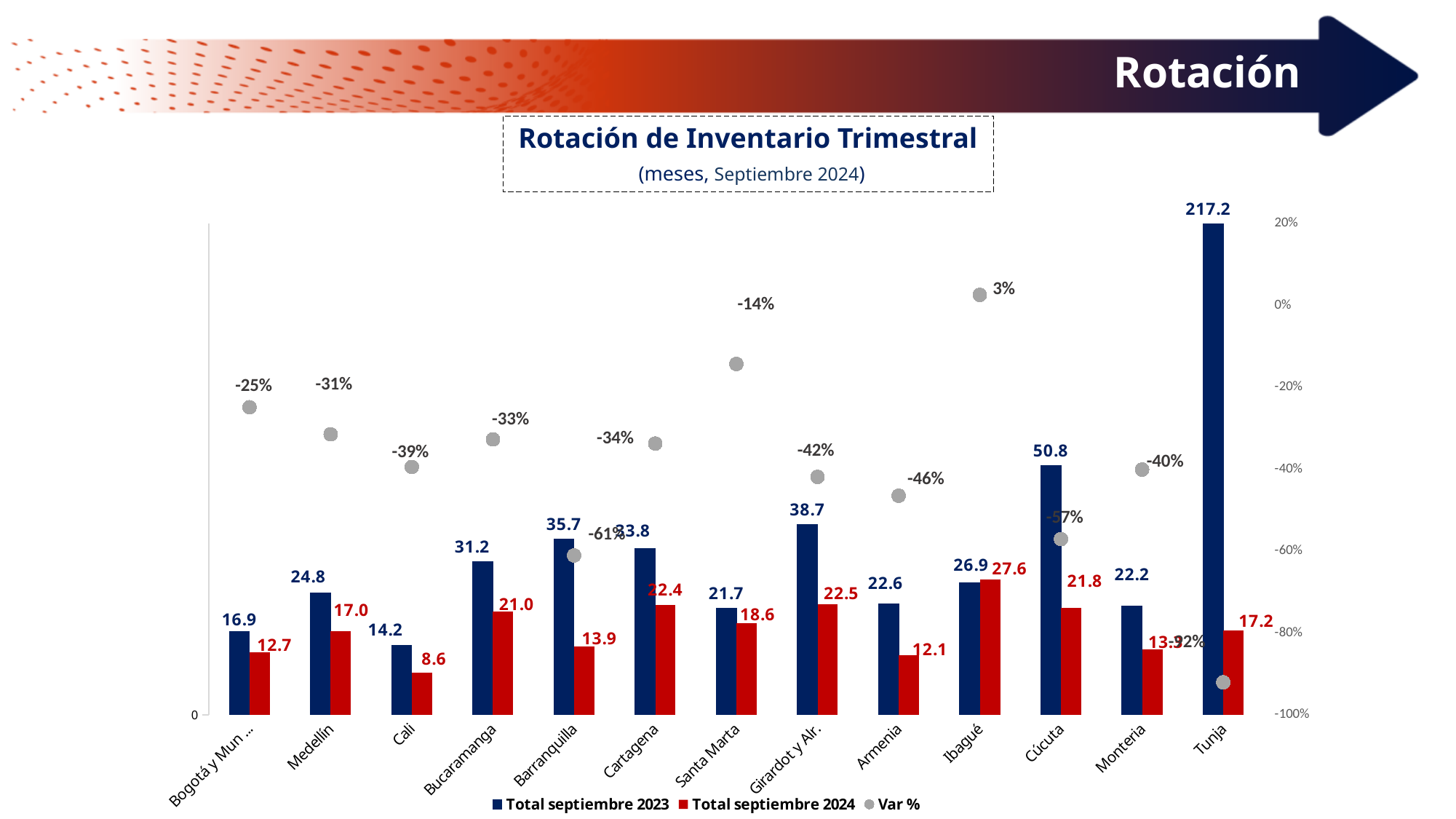
Which city has the highest Total septiembre 2023 value? Tunja What is the Total septiembre 2023 value for Tunja? 217.2 What is the difference between the Total septiembre 2023 and Total septiembre 2024 values for Cúcuta? 29.0 What is the Var % value shown for Ibagué? 3% How many cities are shown on the x axis of the chart? 13 What is the Total septiembre 2024 value for Cali? 8.6 What is the title of the chart? Rotación de Inventario Trimestral Which city has the lowest Total septiembre 2024 value? Cali Which city has the lowest Var % value? Tunja What kind of chart is used to show the Total septiembre 2023 and Total septiembre 2024 values? Bar chart How many series does the legend list? 3 For Ibagué, which is larger: Total septiembre 2023 or Total septiembre 2024? Total septiembre 2024